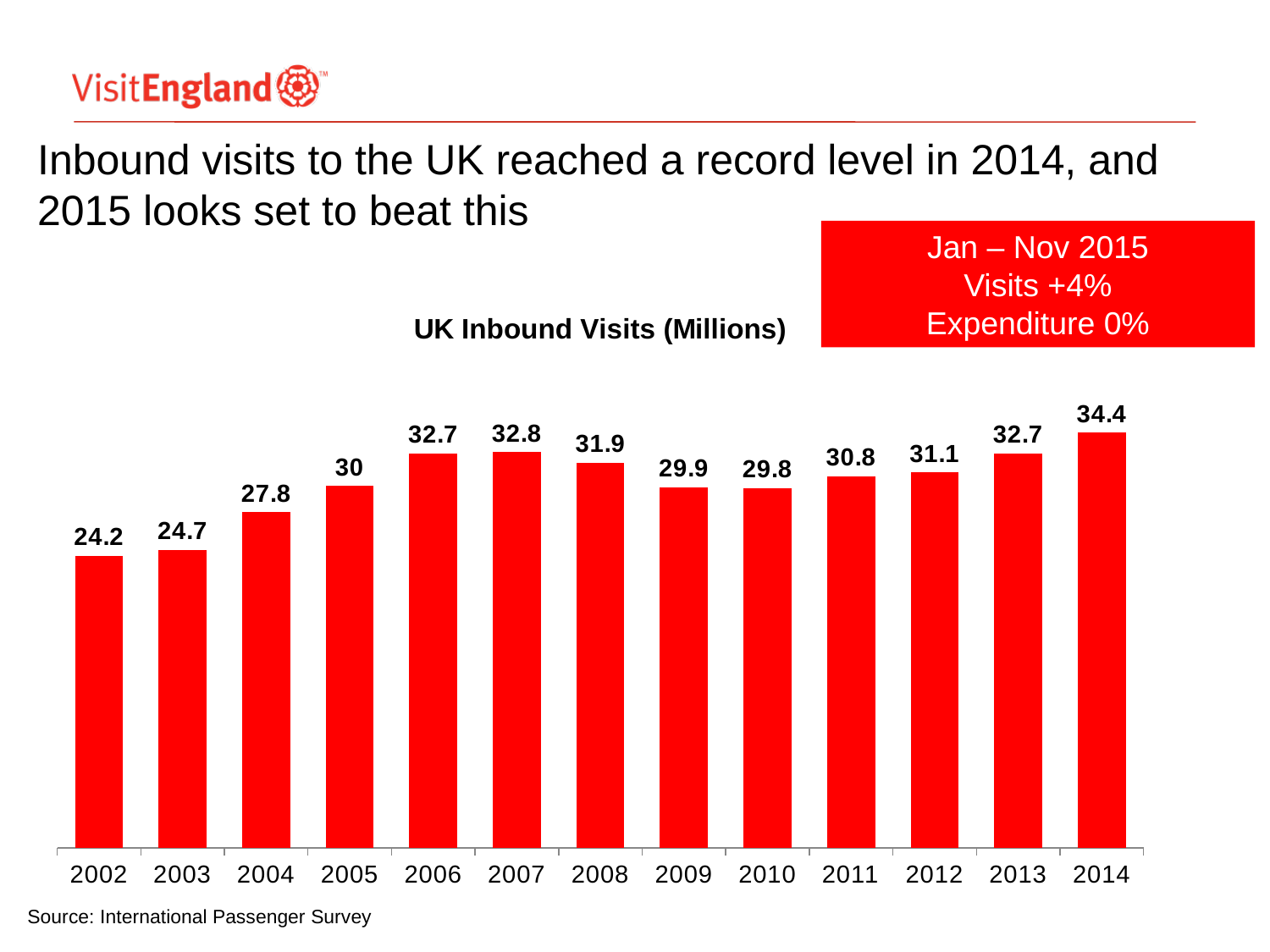
Which is larger in the UK Inbound Visits (Millions) chart, the value for 2005 or the value for 2011? 2011 Which year has the highest value in the UK Inbound Visits (Millions) chart? 2014 What kind of chart is the UK Inbound Visits (Millions) chart? Bar chart What is the title of the chart on the slide? UK Inbound Visits (Millions) What is the difference between the values for 2008 and 2009 in the UK Inbound Visits (Millions) chart? 2 What is the value for 2002 in the UK Inbound Visits (Millions) chart? 24.2 What is the difference between the values for 2014 and 2002 in the UK Inbound Visits (Millions) chart? 10.2 What is the value for 2014 in the UK Inbound Visits (Millions) chart? 34.4 How many years are shown on the x axis of the UK Inbound Visits (Millions) chart? 13 What is the value for 2009 in the UK Inbound Visits (Millions) chart? 29.9 Do the values in the UK Inbound Visits (Millions) chart rise or fall from 2002 to 2007? Rise Which year has the lowest value in the UK Inbound Visits (Millions) chart? 2002